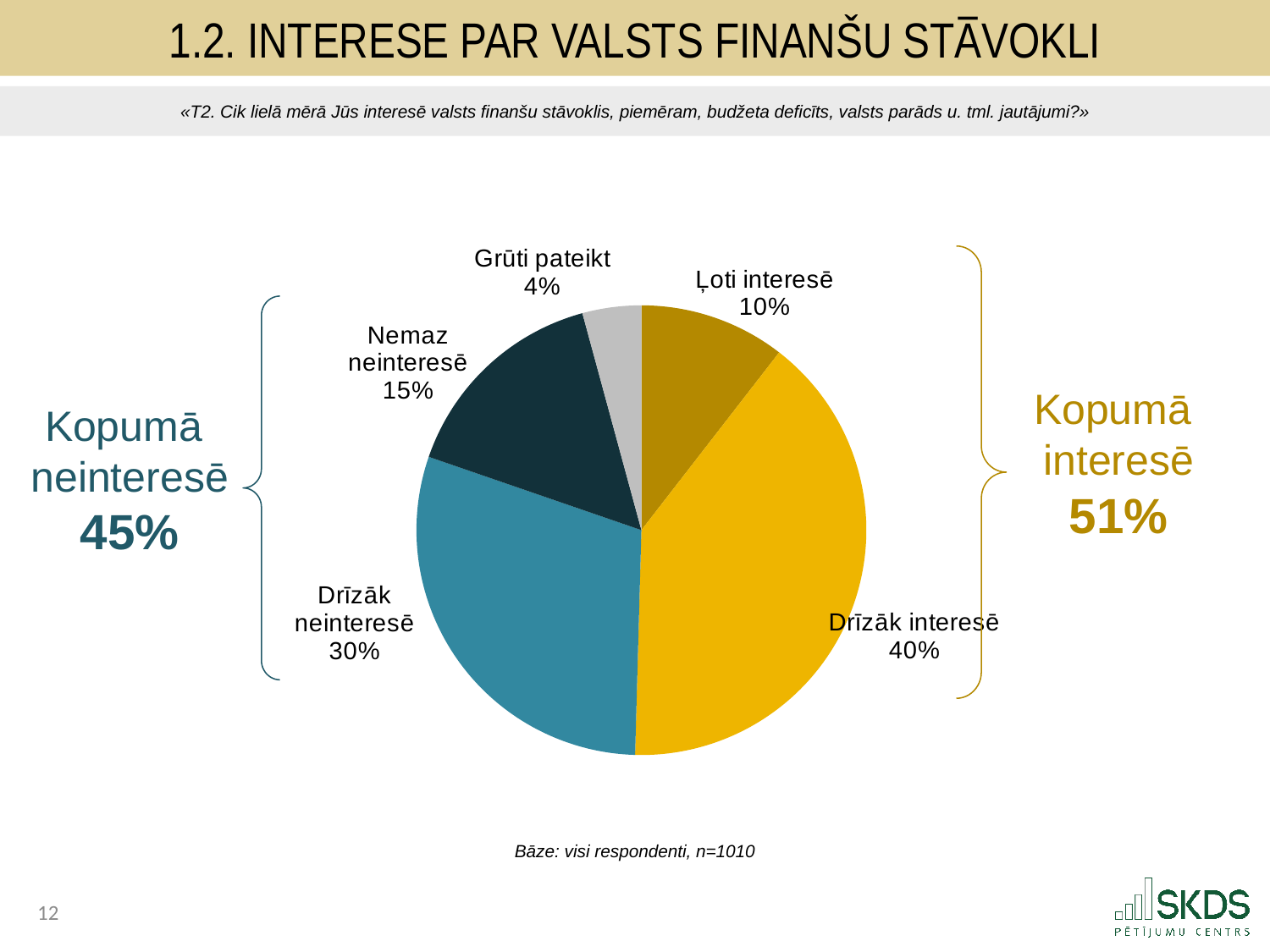
Which category has the smallest slice of the pie? Grūti pateikt What kind of chart is shown on the slide? pie chart What is the difference in percentage points between "Drīzāk interesē" and "Drīzāk neinteresē"? 10 What is the combined share labelled "Kopumā interesē"? 51% Which is larger, "Nemaz neinteresē" or "Ļoti interesē"? Nemaz neinteresē What is the combined share labelled "Kopumā neinteresē"? 45% What share of respondents answered "Nemaz neinteresē"? 15% Which category has the largest slice of the pie? Drīzāk interesē What share of respondents answered "Ļoti interesē"? 10% What share of respondents answered "Grūti pateikt"? 4% What share of respondents answered "Drīzāk interesē"? 40% How many slices does the pie chart have? 5